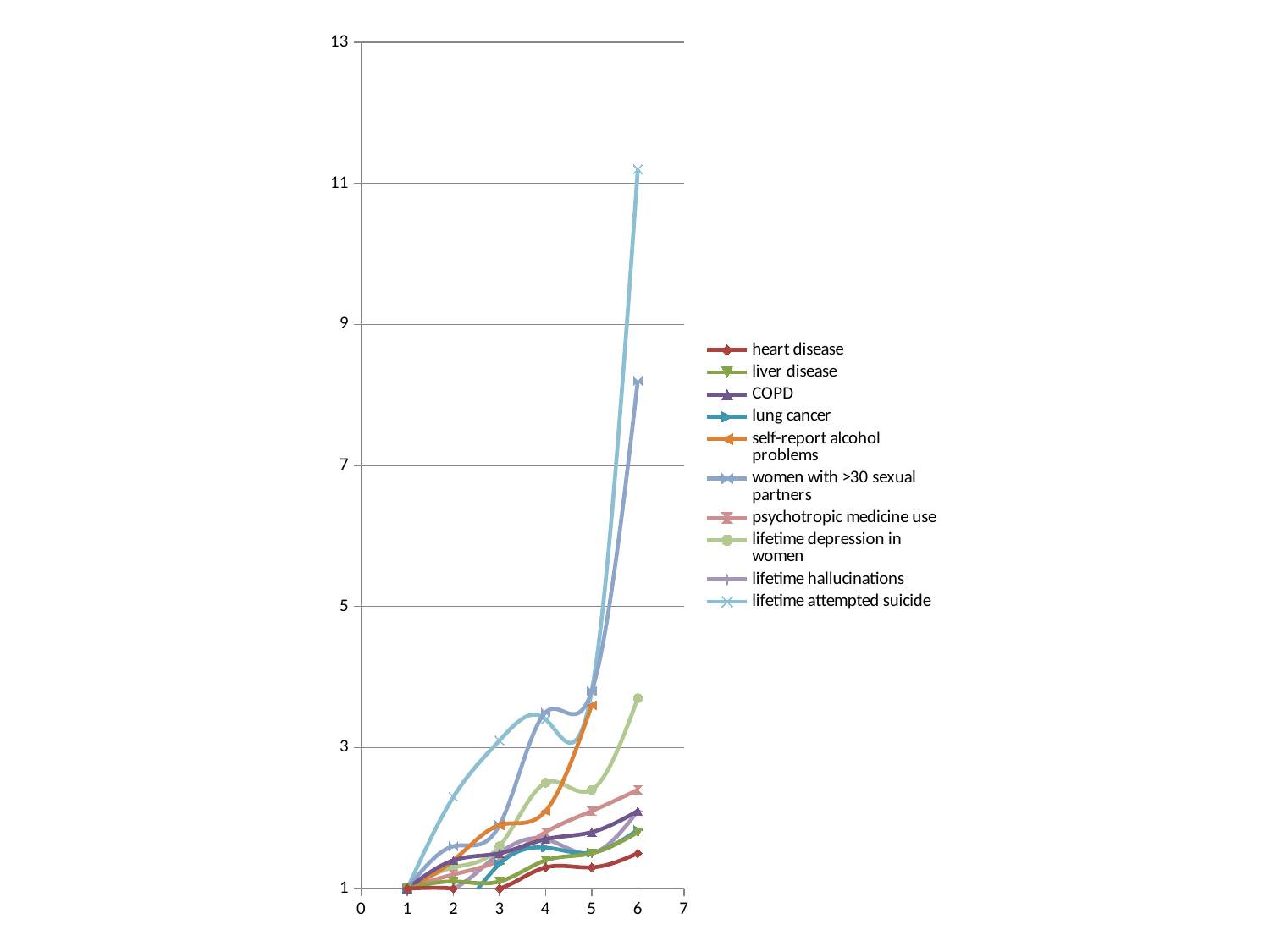
Is the value for heart disease at x = 6 greater or less than 3? less Which series has the highest value at x = 6? lifetime attempted suicide Is the value for lifetime depression in women at x = 6 greater or less than 3? greater Does the lifetime attempted suicide series rise or fall from x = 1 to x = 6? rise Which series is listed first in the legend? heart disease How many data points does the heart disease series have? 6 Is the value for lifetime attempted suicide at x = 6 greater or less than 11? greater How many series does the legend list? 10 What kind of chart is shown on the slide? line chart At x = 6, which is larger: lifetime attempted suicide or women with >30 sexual partners? lifetime attempted suicide